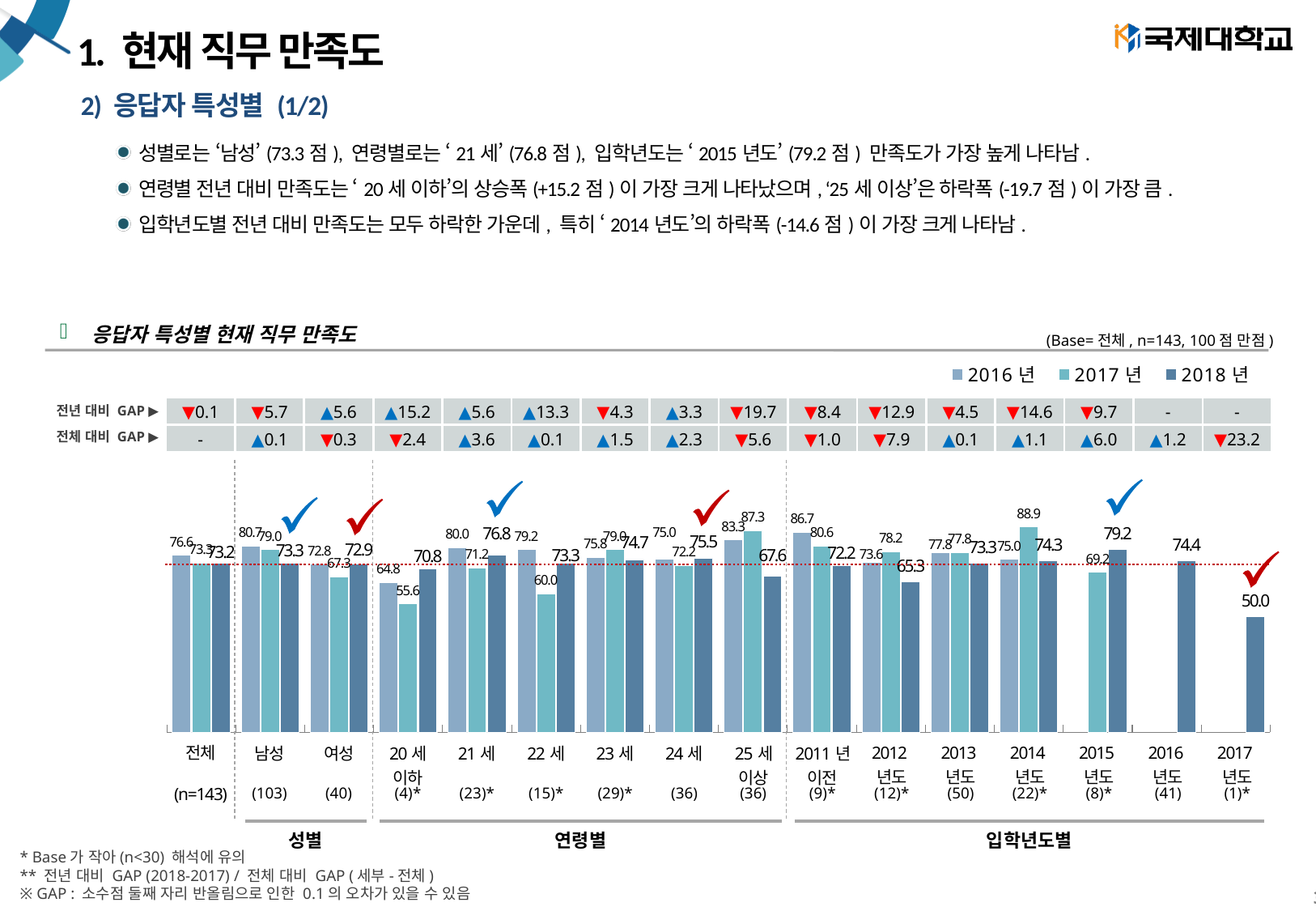
What is the 2017년 value for 25세 이상? 87.3 Which category has the highest 2018년 value? 2015년도 Which is larger, the 2016년 value for 2011년 이전 or the 2016년 value for 2012년도? 2011년 이전 How many series does the legend of the chart list? 3 What is the 2018년 value for 남성? 73.3 Do the values for 2011년 이전 rise or fall from 2016년 to 2018년? fall What kind of chart is shown on the slide? bar chart Which category has the lowest 2018년 value? 2017년도 What are the three series listed in the chart legend? 2016년, 2017년, 2018년 What is the 2016년 value for 21세? 80.0 What is the 2018년 value for 2017년도? 50.0 What is the difference between the 2017년 and 2018년 values for 25세 이상? 19.7